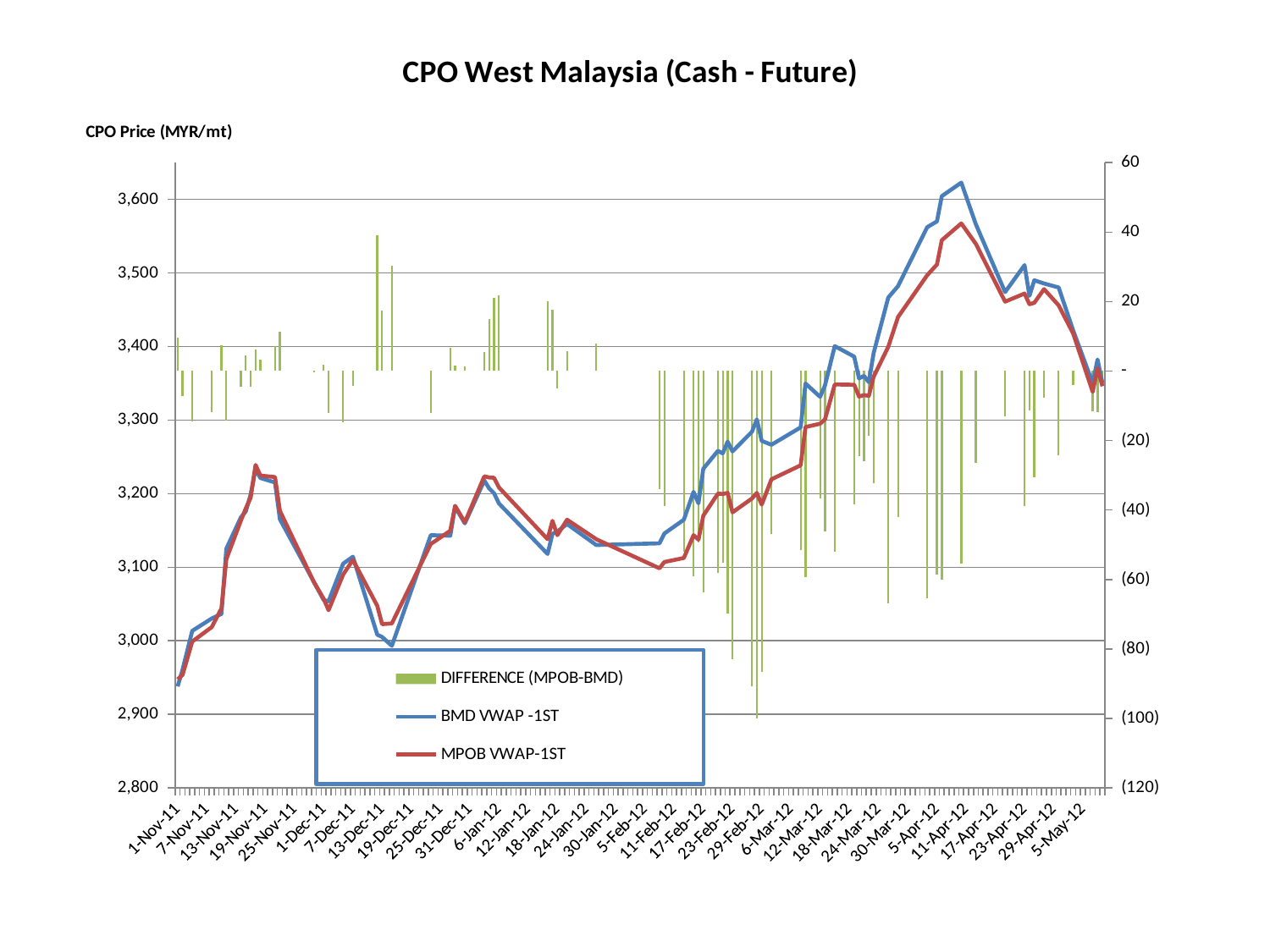
Around 19-Dec-11, which series is higher: BMD VWAP -1ST or MPOB VWAP-1ST? MPOB VWAP-1ST Does the BMD VWAP -1ST line rise or fall from 1-Nov-11 to 19-Nov-11? rise What is the title of the chart? CPO West Malaysia (Cash - Future) Around 11-Apr-12, which series is higher: BMD VWAP -1ST or MPOB VWAP-1ST? BMD VWAP -1ST Is the peak BMD VWAP -1ST value, around 11-Apr-12, greater or less than 3,600? greater Is the BMD VWAP -1ST value at 1-Nov-11 greater or less than 3,000? less What is the label of the left vertical axis? CPO Price (MYR/mt) How many series does the legend list? 3 Does the BMD VWAP -1ST line rise or fall from 11-Apr-12 to 5-May-12? fall Is the MPOB VWAP-1ST value around 11-Apr-12 greater or less than 3,600? less What kind of chart is this? Combination line and bar chart